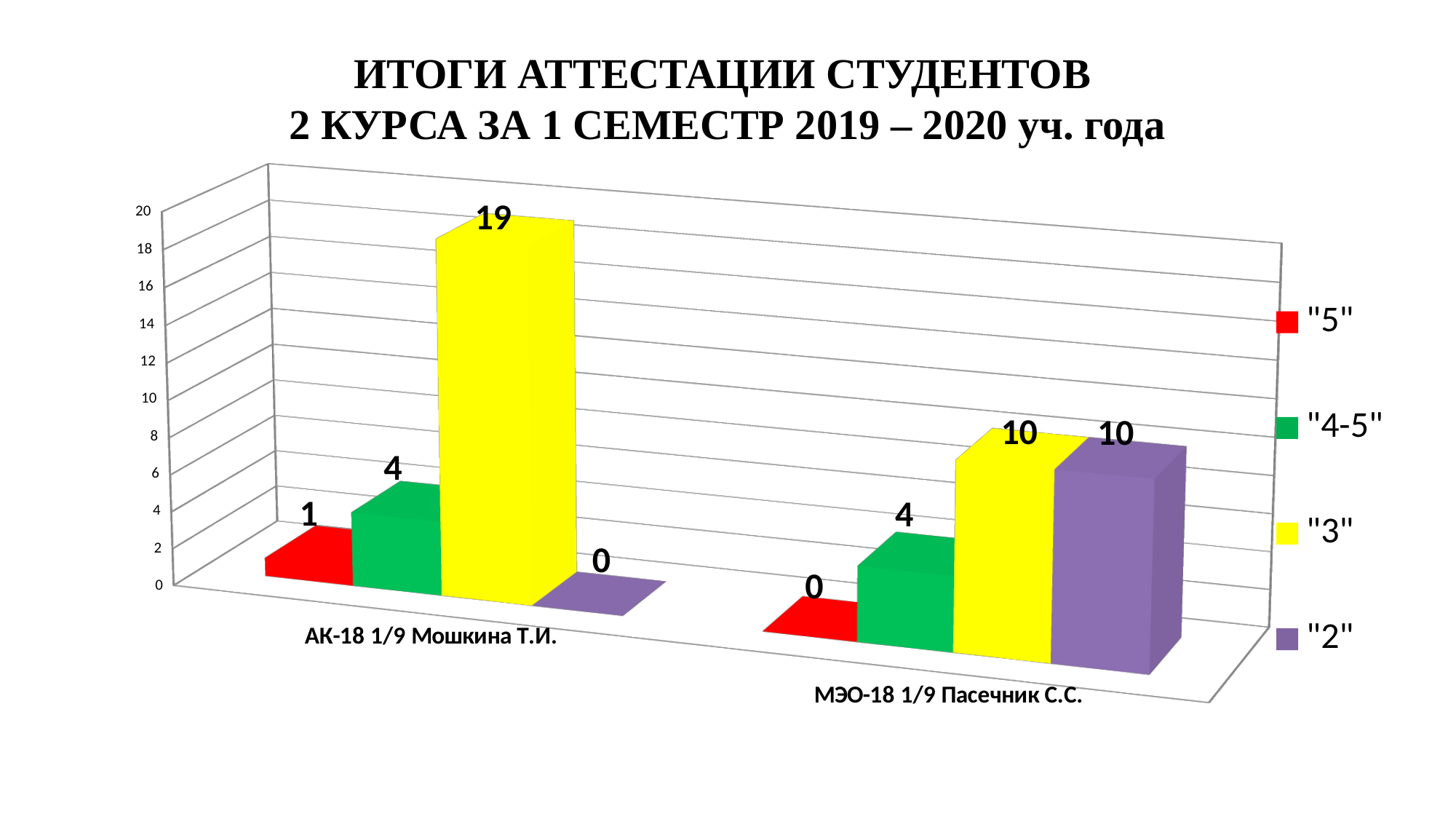
Which series has the lowest value in the МЭО-18 1/9 Пасечник С.С. group? "5" How many series does the legend list? 4 How many groups (categories) are shown on the x axis? 2 Which series has the highest value in the АК-18 1/9 Мошкина Т.И. group? "3" What is the value for "3" in the АК-18 1/9 Мошкина Т.И. group? 19 What is the value for "5" in the МЭО-18 1/9 Пасечник С.С. group? 0 What kind of chart is shown on the slide? Bar chart What is the difference between the "3" values for АК-18 1/9 Мошкина Т.И. and МЭО-18 1/9 Пасечник С.С.? 9 What colour represents the "4-5" series in the legend? Green What is the value for "2" in the МЭО-18 1/9 Пасечник С.С. group? 10 Which group has the larger value for "2": АК-18 1/9 Мошкина Т.И. or МЭО-18 1/9 Пасечник С.С.? МЭО-18 1/9 Пасечник С.С. What is the value for "5" in the АК-18 1/9 Мошкина Т.И. group? 1